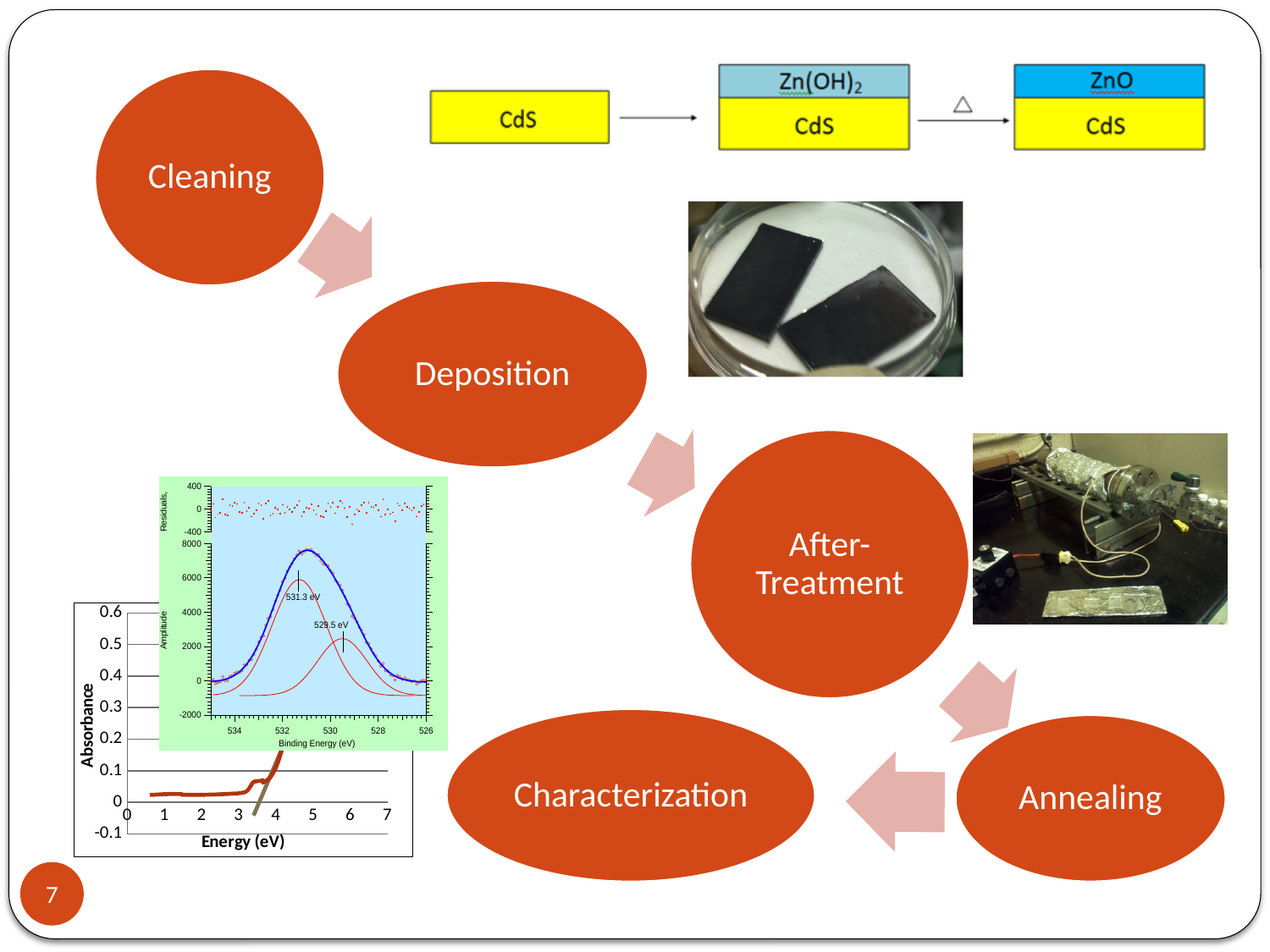
In the binding energy spectrum chart, how many labeled fitted peaks are shown? 2 In the absorbance chart at the bottom left, is the absorbance at 2 eV greater or less than 0.2? less In the binding energy spectrum chart, is the amplitude of the 529.5 eV peak greater or less than 4000? less What is the y-axis label of the absorbance chart at the bottom left of the slide? Absorbance In the binding energy spectrum chart, what binding energy is labeled on the smaller fitted peak? 529.5 eV What is the x-axis label of the binding energy spectrum chart in the middle left of the slide? Binding Energy (eV) What kind of chart is the absorbance versus energy chart at the bottom left of the slide? line chart In the binding energy spectrum chart, which labeled fitted peak has the higher amplitude, 531.3 eV or 529.5 eV? 531.3 eV What is the x-axis label of the absorbance chart at the bottom left of the slide? Energy (eV) In the absorbance chart at the bottom left, does the absorbance rise or fall as energy increases from 3 eV to 4 eV? rise In the binding energy spectrum chart, what binding energy is labeled on the larger fitted peak? 531.3 eV In the absorbance chart at the bottom left, is the absorbance at 1 eV greater or less than 0.1? less